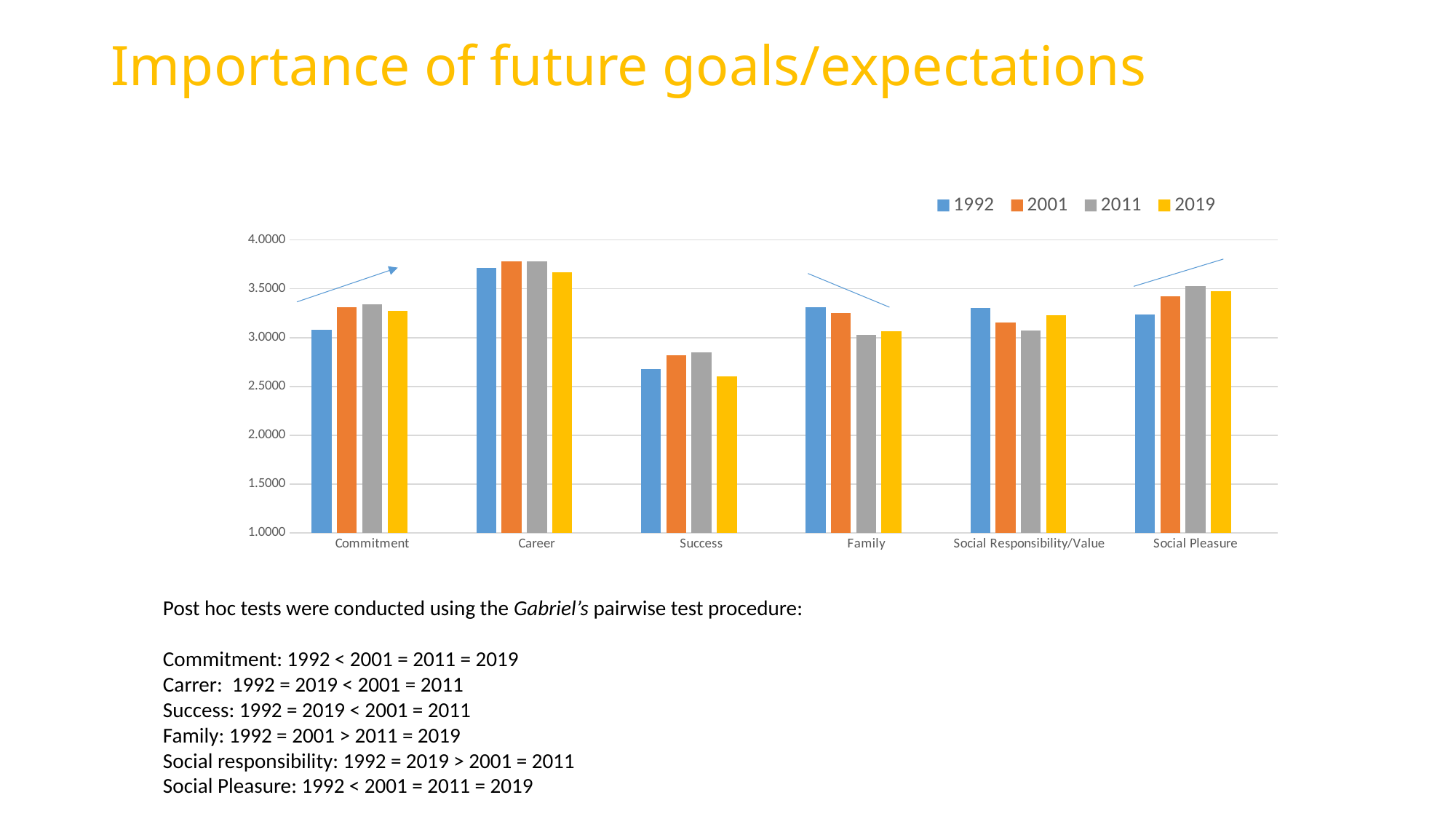
For Social Pleasure, which is larger: the 1992 value or the 2011 value? 2011 Which years are listed in the legend? 1992, 2001, 2011, 2019 How many categories are shown on the x axis? 6 What kind of chart is shown on the slide? Bar chart Is the value for Career in 2001 greater or less than 3.5? greater Is the value for Success in 2019 greater or less than 3.0? less For Family, which is larger: the 1992 value or the 2011 value? 1992 Which category has the lowest value for 2019? Success Which category has the highest bars overall? Career How many series does the legend list? 4 Is the value for Success in 1992 greater or less than 3.0? less Which is larger: the 1992 value for Career or the 1992 value for Success? Career